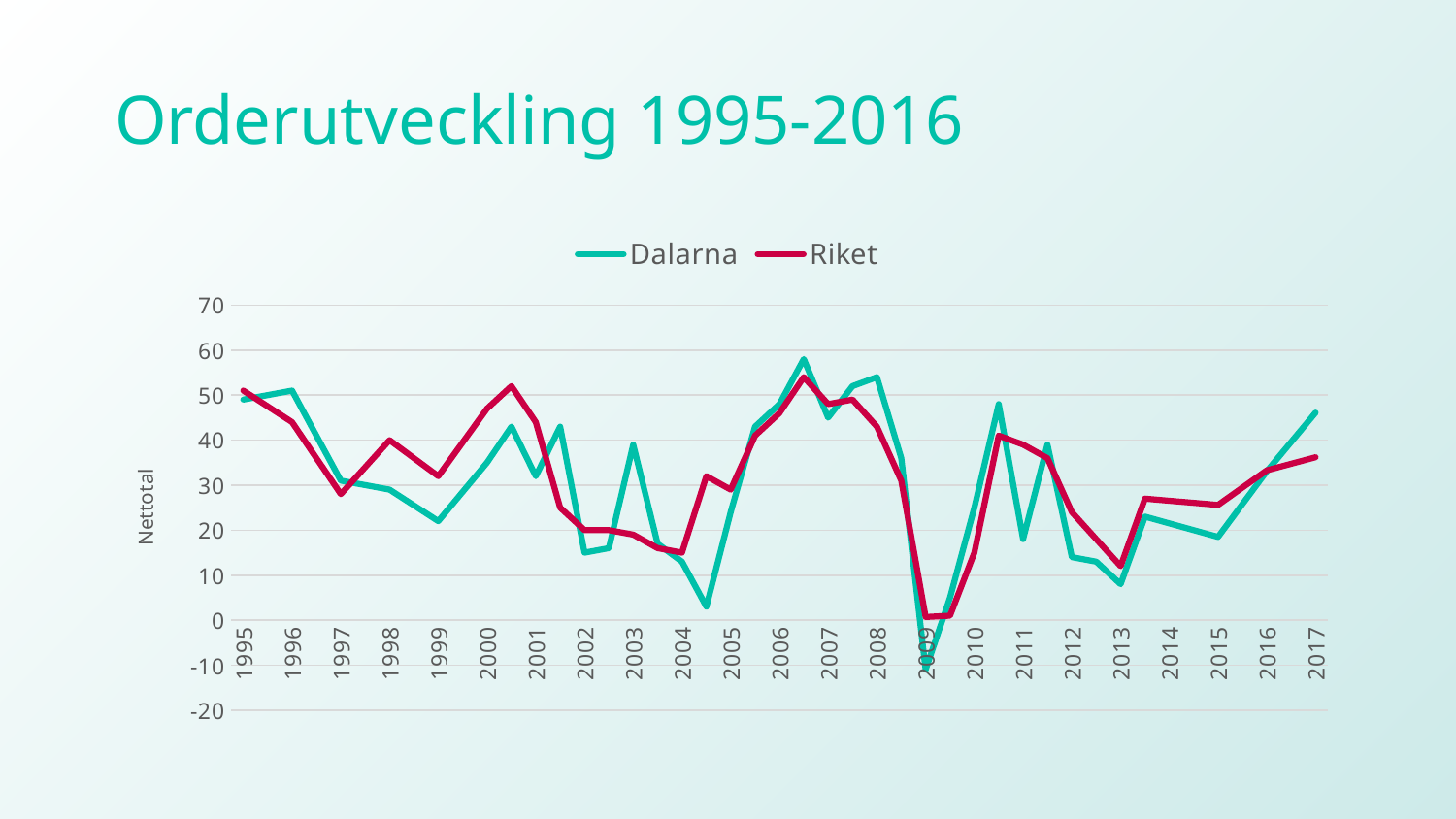
Is the value for Riket in 2017 greater or less than 40? less Is the value for Dalarna in 2009 greater or less than 0? less What is the title of the chart on the slide? Orderutveckling 1995-2016 Is the value for Riket in 1995 greater or less than 40? greater What is the label on the vertical axis? Nettotal In 1999, which series has the higher value, Dalarna or Riket? Riket What kind of chart is shown on the slide? line chart In 2017, which series has the higher value, Dalarna or Riket? Dalarna How many series does the legend list? 2 How many years are labelled along the x axis? 23 In which year does the Dalarna line reach its lowest value? 2009